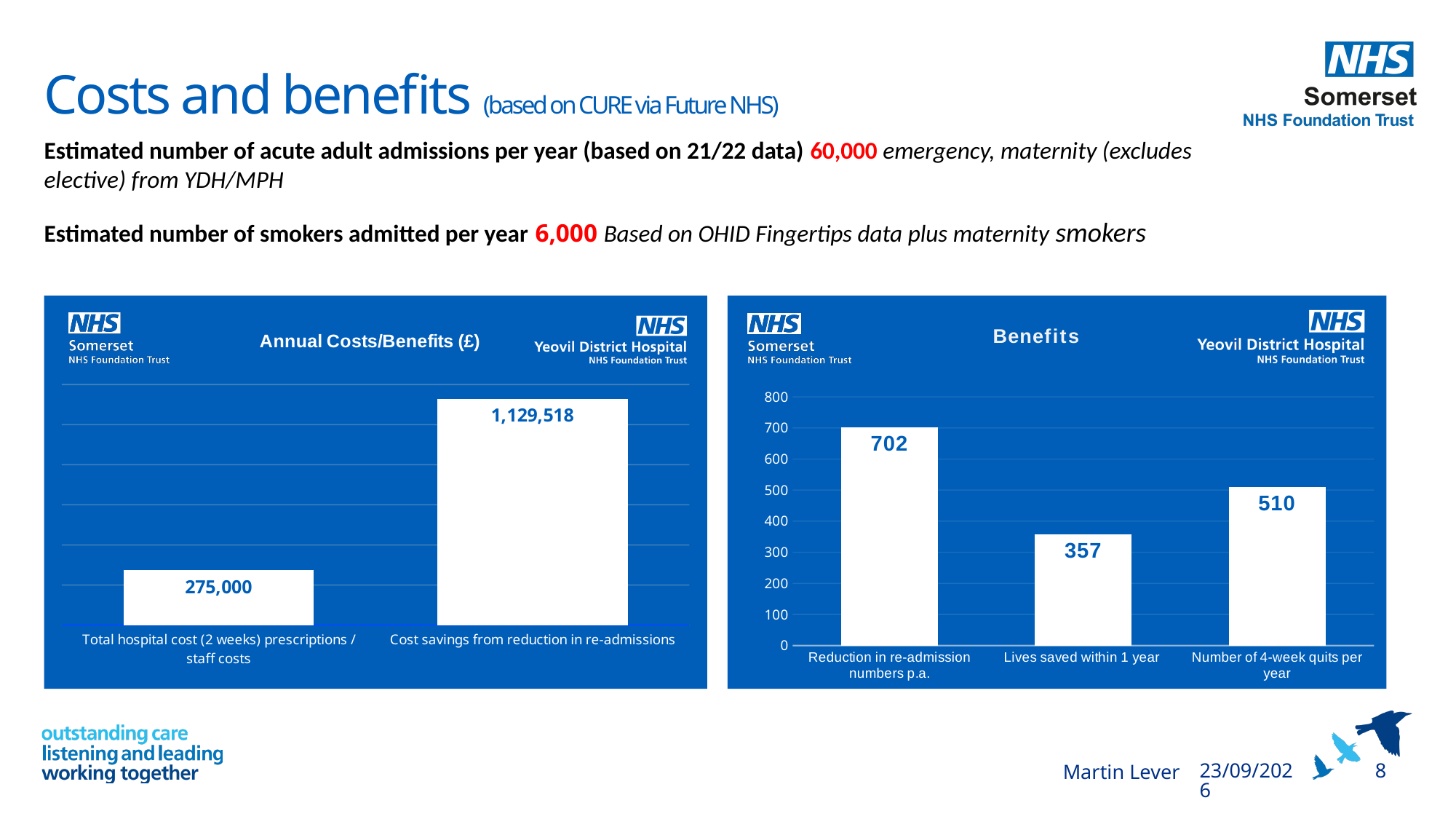
In the 'Benefits' chart, what is the value for 'Number of 4-week quits per year'? 510 In the 'Annual Costs/Benefits (£)' chart, how many bars are plotted? 2 In the 'Benefits' chart, what is the difference between 'Reduction in re-admission numbers p.a.' and 'Number of 4-week quits per year'? 192 In the 'Annual Costs/Benefits (£)' chart, what is the value for 'Total hospital cost (2 weeks) prescriptions / staff costs'? 275,000 In the 'Benefits' chart, how many categories are shown on the x axis? 3 In the 'Benefits' chart, what is the value for 'Reduction in re-admission numbers p.a.'? 702 In the 'Benefits' chart, which category has the lowest value? Lives saved within 1 year In the 'Annual Costs/Benefits (£)' chart, what is the value for 'Cost savings from reduction in re-admissions'? 1,129,518 In the 'Annual Costs/Benefits (£)' chart, what is the difference between the cost savings and the total hospital cost? 854,518 In the 'Annual Costs/Benefits (£)' chart, which category has the higher value? Cost savings from reduction in re-admissions What type of chart is the 'Benefits' chart? Bar chart In the 'Benefits' chart, what is the value for 'Lives saved within 1 year'? 357